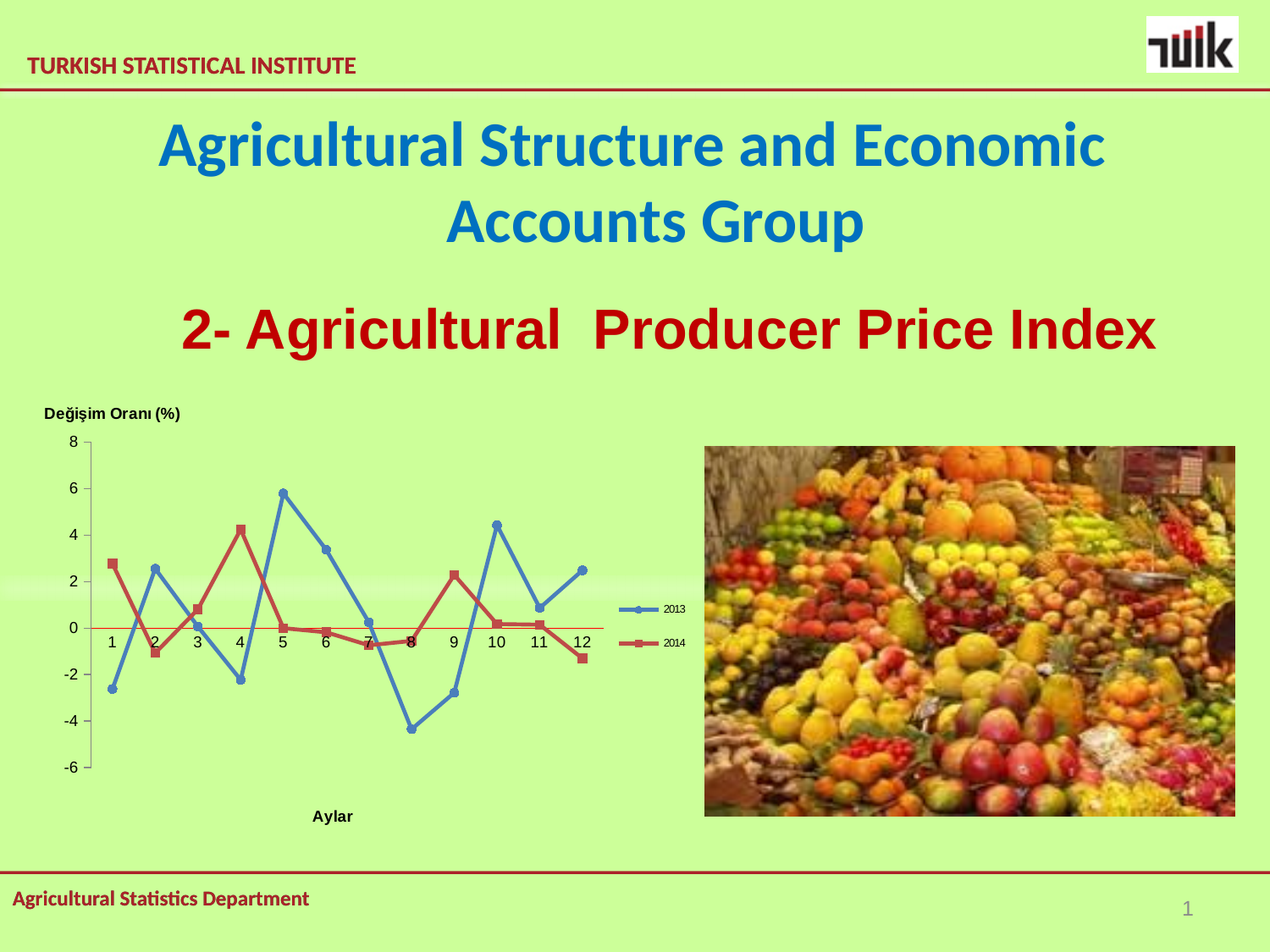
In which month does the 2014 series reach its highest value? 4 Is the value for 2013 in month 8 greater or less than -2? less In which month does the 2013 series reach its highest value? 5 How many series does the chart legend list? 2 In month 1, which series has the larger value, 2013 or 2014? 2014 In which month does the 2013 series reach its lowest value? 8 What is the title of the vertical axis of the chart? Değişim Oranı (%) Does the 2013 series rise or fall from month 8 to month 10? rise What kind of chart is shown on the slide? line chart Which years are listed in the chart legend? 2013 and 2014 How many months (points) are plotted along the x axis for each series? 12 Is the value for 2013 in month 5 greater or less than 4? greater